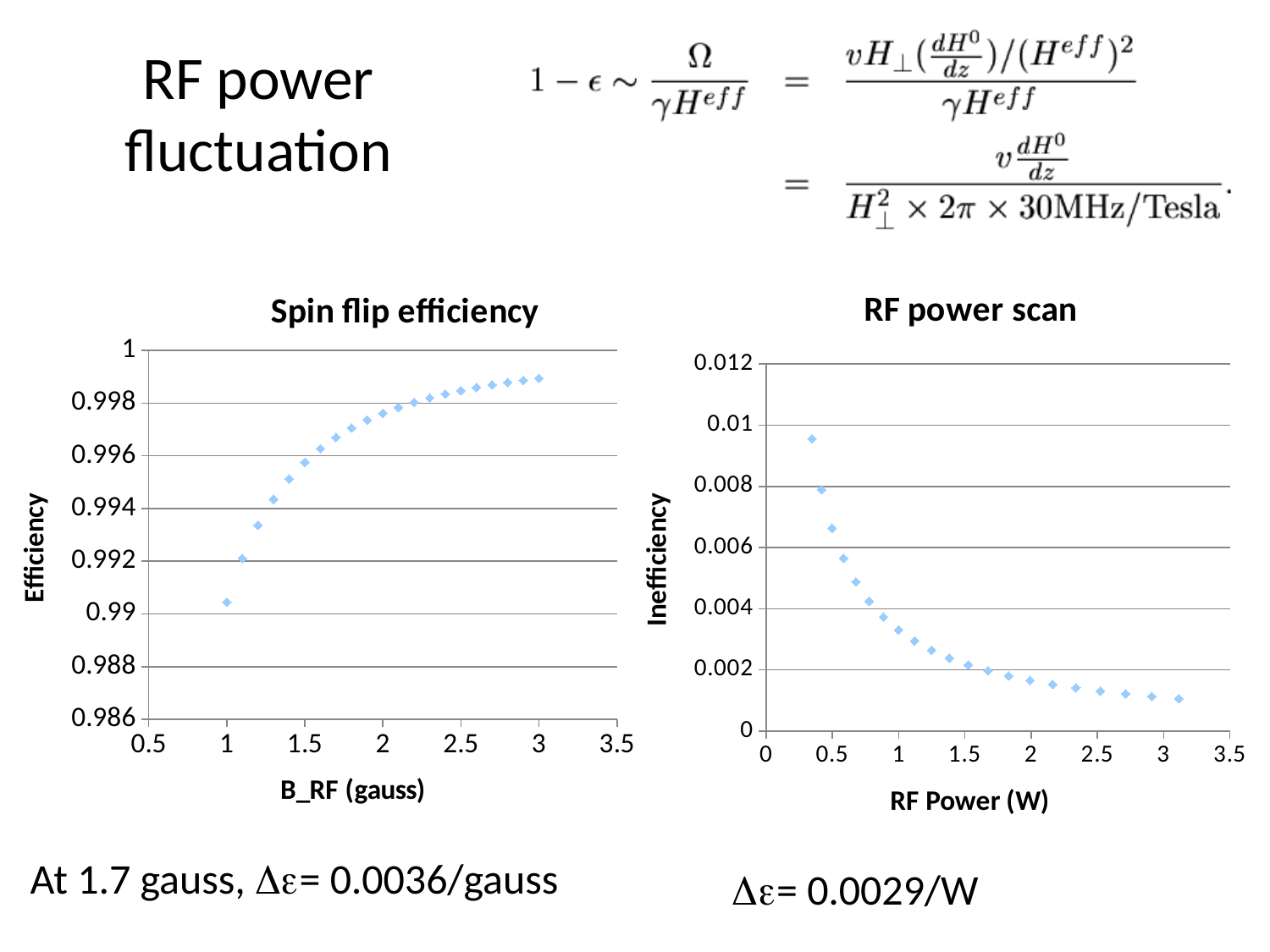
In the "Spin flip efficiency" chart, which has the higher efficiency: 1 gauss or 3 gauss? 3 gauss In the "Spin flip efficiency" chart, is the efficiency at 1.5 gauss greater or less than 0.994? greater In the "RF power scan" chart, which has the higher inefficiency: 0.5 W or 2 W? 0.5 W What is the y-axis title of the "RF power scan" chart? Inefficiency In the "RF power scan" chart, is the inefficiency at 0.5 W greater or less than 0.006? greater In the "Spin flip efficiency" chart, do the values rise or fall as B_RF increases? rise In the "Spin flip efficiency" chart, is the efficiency at 3 gauss greater or less than 0.998? greater What kind of chart is the "Spin flip efficiency" chart? scatter chart What is the x-axis title of the "Spin flip efficiency" chart? B_RF (gauss) In the "RF power scan" chart, do the values rise or fall as RF Power increases? fall